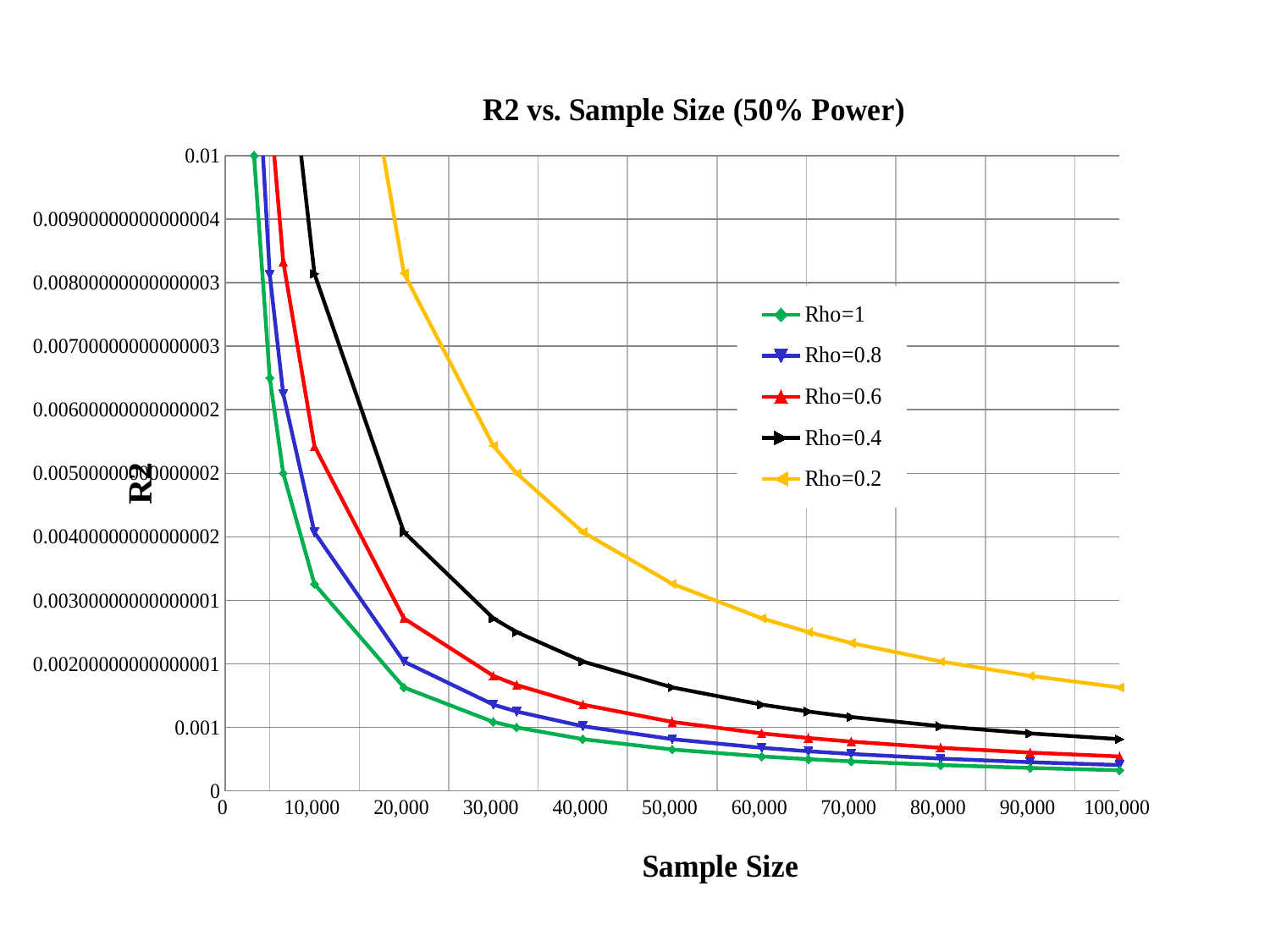
Is the value for Rho=0.2 at a sample size of 100,000 greater or less than 0.001? greater At a sample size of 50,000, which series has the larger R2, Rho=0.2 or Rho=1? Rho=0.2 Is the value for Rho=0.4 at a sample size of 100,000 greater or less than 0.001? less Which series is drawn in yellow? Rho=0.2 Is the value for Rho=0.6 at a sample size of 20,000 greater or less than 0.003? less What is the title of the chart? R2 vs. Sample Size (50% Power) Which series has the highest R2 at a sample size of 100,000? Rho=0.2 Which series has the lowest R2 at a sample size of 100,000? Rho=1 What kind of chart is shown on the slide? line chart Do the R2 values rise or fall as Sample Size increases? fall How many series does the legend list? 5